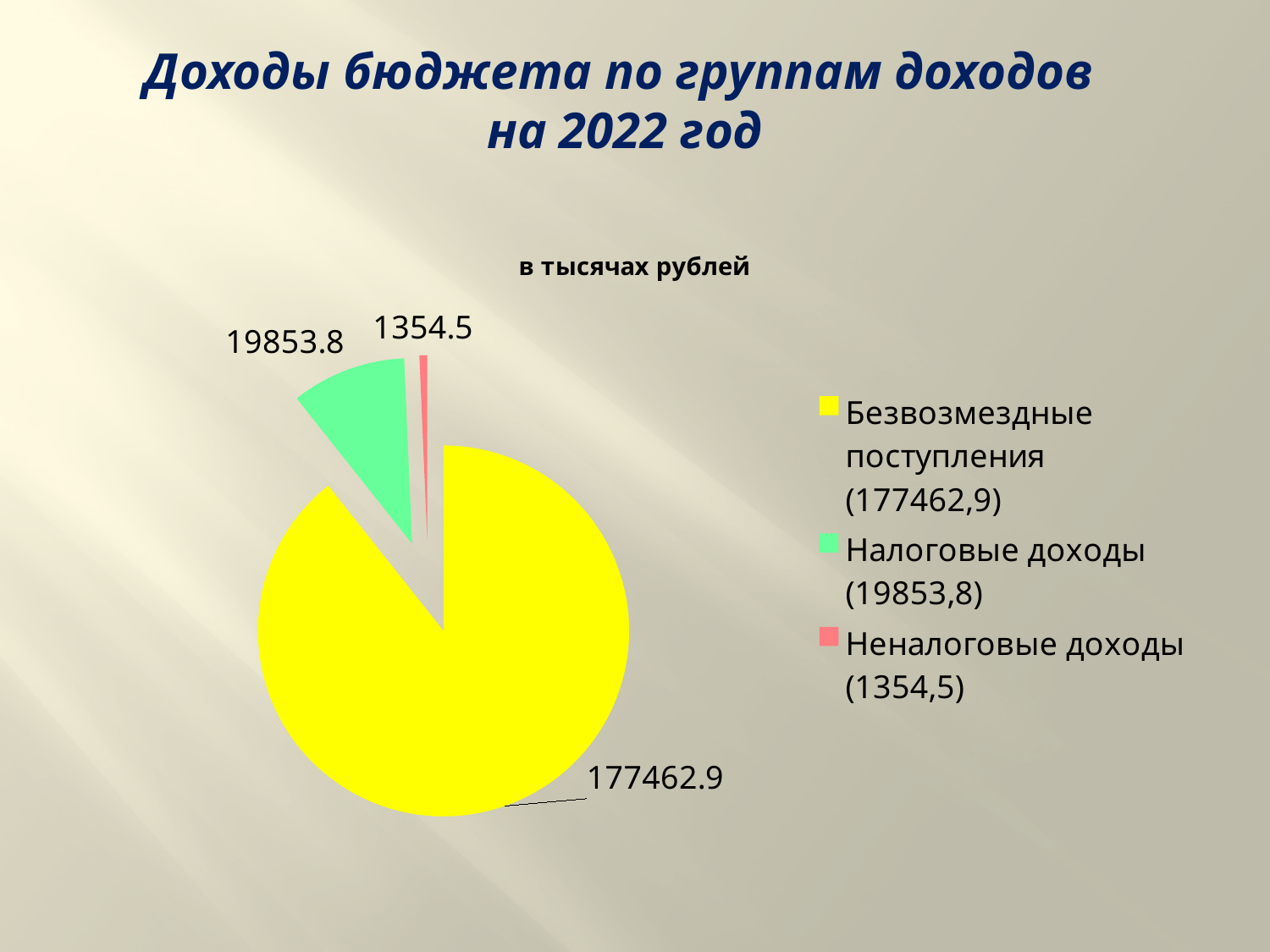
What is the value for Неналоговые доходы? 1354.5 Which category has the largest slice of the pie? Безвозмездные поступления What is the value for Безвозмездные поступления? 177462.9 Which category has the smallest slice of the pie? Неналоговые доходы What is the difference between Налоговые доходы and Неналоговые доходы? 18499.3 What type of chart is shown on the slide? pie chart Which is larger, Налоговые доходы or Неналоговые доходы? Налоговые доходы What is the difference between Безвозмездные поступления and Налоговые доходы? 157609.1 What is the value for Налоговые доходы? 19853.8 How many slices does the pie chart have? 3 How many entries does the legend list? 3 What unit is stated in the chart title? в тысячах рублей